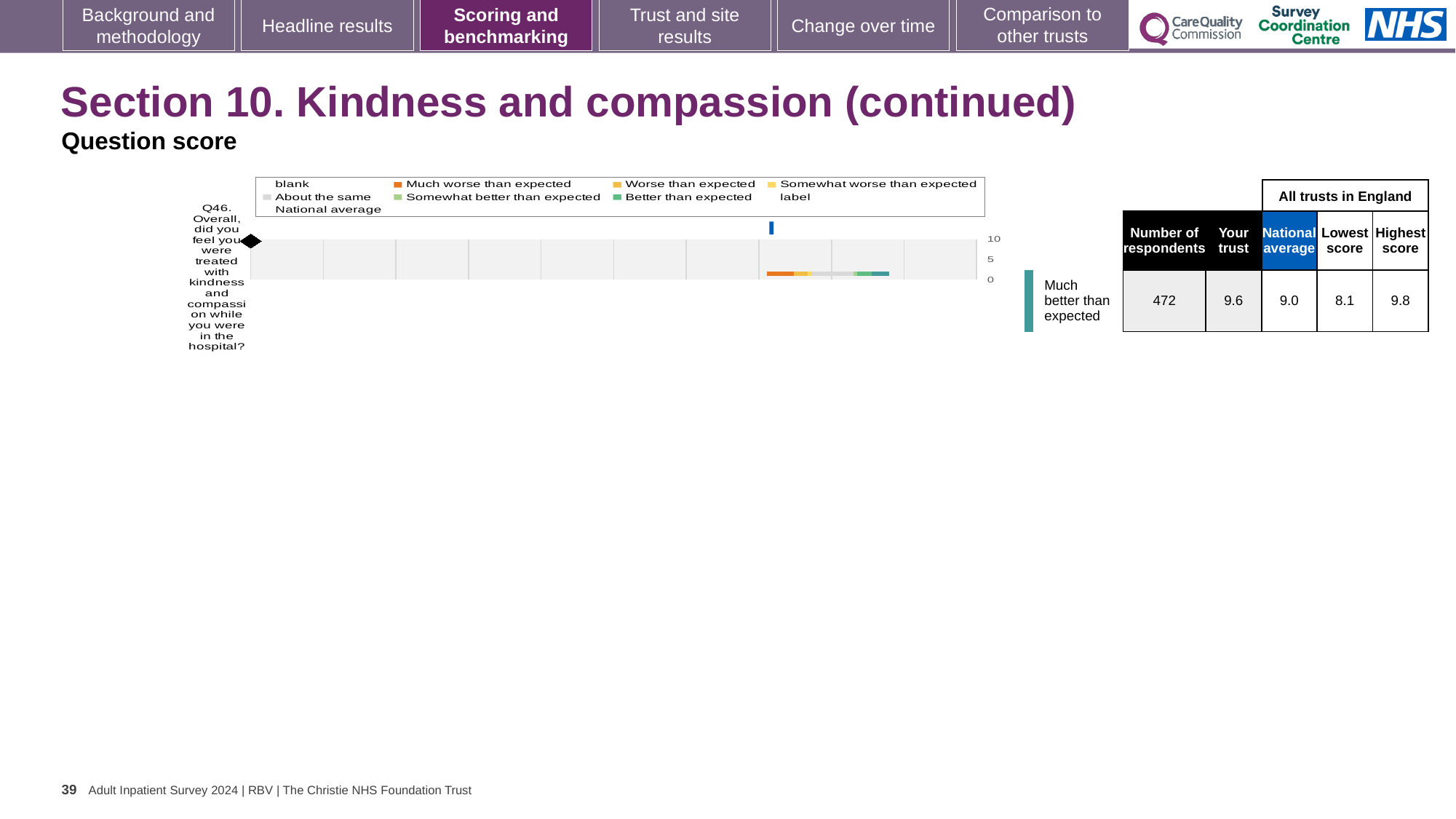
In the table, what is the number of respondents for Q46? 472 In the table, what is the 'Your trust' score for Q46? 9.6 In the table, what is the highest score among all trusts in England for Q46? 9.8 What kind of chart is shown on the slide? bar chart What benchmark category is the trust's Q46 score assigned to on the slide? Much better than expected What is the highest value shown on the chart's axis? 10 How many questions (categories) are plotted in the chart? 1 In the table, what is the national average score for Q46? 9.0 In the table, which is larger for Q46: the 'Your trust' score or the national average? Your trust In the table, what is the difference between the 'Your trust' score and the national average for Q46? 0.6 Which question number is plotted in the chart? Q46 In the table, what is the lowest score among all trusts in England for Q46? 8.1